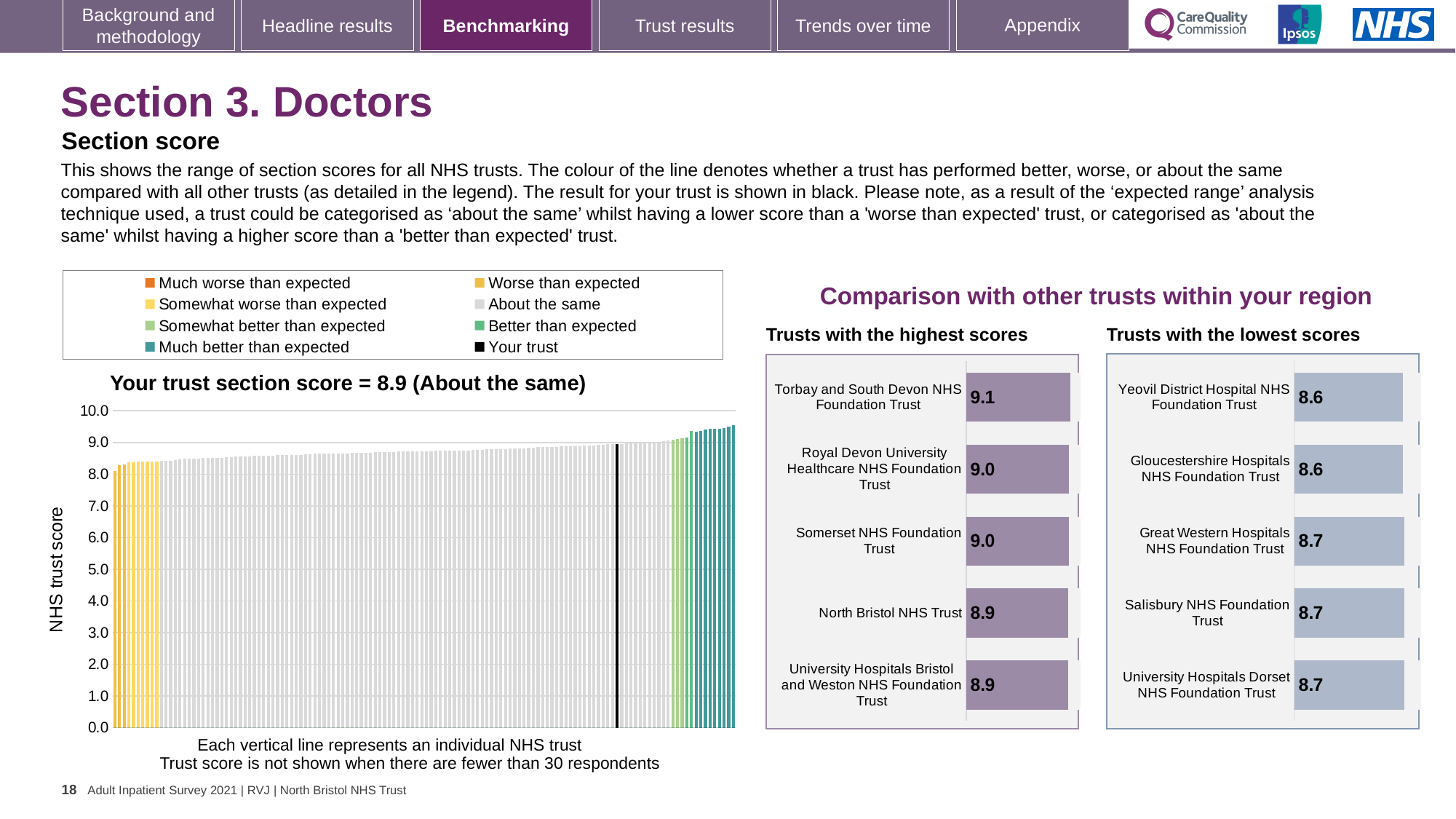
On the 'Trusts with the lowest scores' chart, what is the difference between the scores of Great Western Hospitals NHS Foundation Trust and Gloucestershire Hospitals NHS Foundation Trust? 0.1 On the 'Trusts with the highest scores' chart, which has the larger score: Torbay and South Devon NHS Foundation Trust or Somerset NHS Foundation Trust? Torbay and South Devon NHS Foundation Trust On the 'Trusts with the highest scores' chart, what is the score for North Bristol NHS Trust? 8.9 On the 'Trusts with the highest scores' chart, what is the difference between the scores of Torbay and South Devon NHS Foundation Trust and North Bristol NHS Trust? 0.2 On the 'Trusts with the lowest scores' chart, what is the score for Yeovil District Hospital NHS Foundation Trust? 8.6 On the 'Your trust section score' chart on the left, do the bar values rise or fall from left to right along the x axis? Rise How many trusts are listed on the 'Trusts with the lowest scores' chart? 5 On the 'Trusts with the lowest scores' chart, what is the score for Salisbury NHS Foundation Trust? 8.7 What kind of chart is the 'Your trust section score' chart on the left of the slide? Bar chart How many entries does the legend above the 'Your trust section score' chart list? 8 On the 'Trusts with the highest scores' chart, which trust has the highest score? Torbay and South Devon NHS Foundation Trust On the 'Trusts with the highest scores' chart, what is the score for Torbay and South Devon NHS Foundation Trust? 9.1